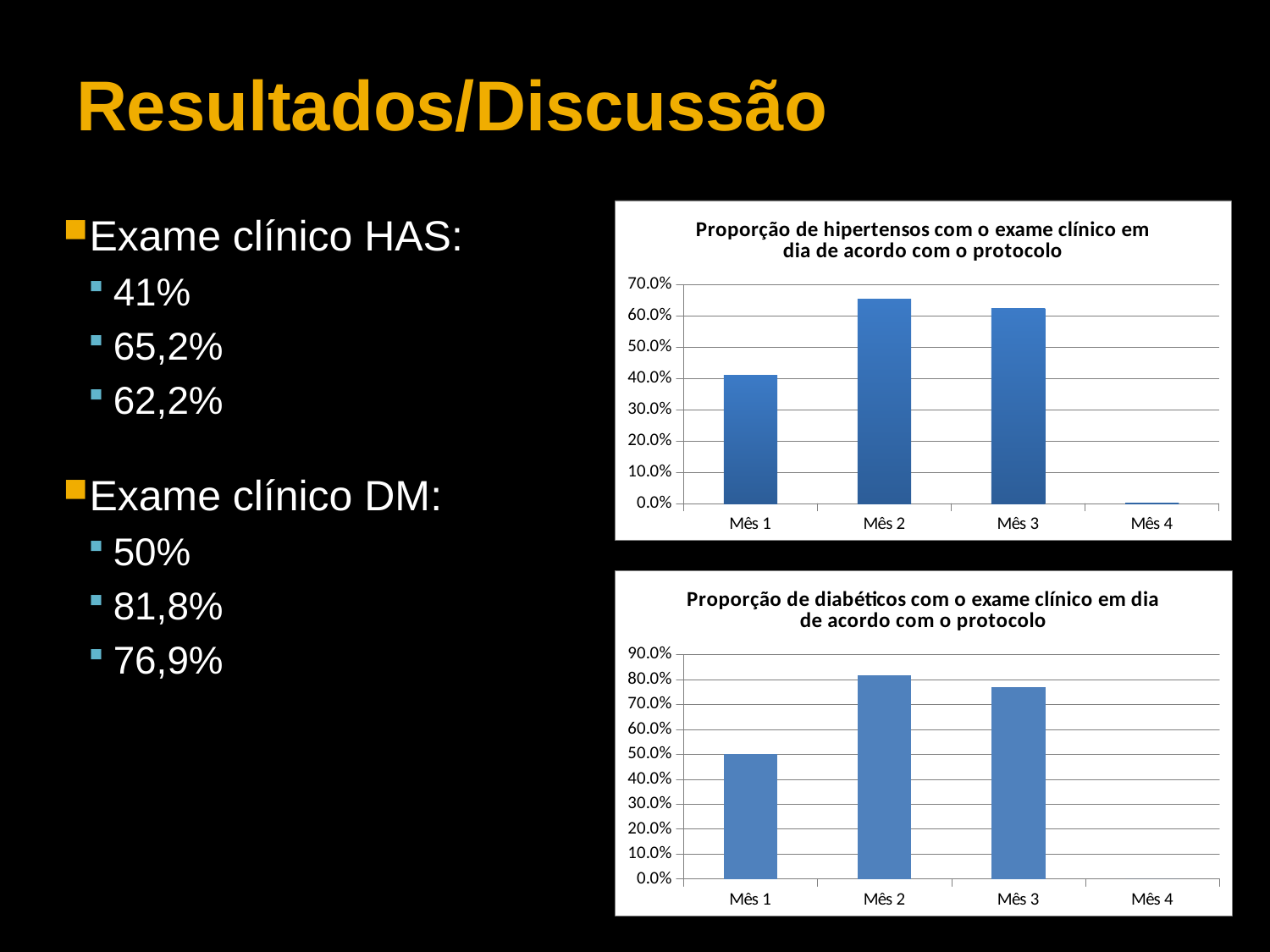
In the top chart (hipertensos), is the value for Mês 1 greater or less than 50.0%? less In the bottom chart (diabéticos), is the value for Mês 2 greater or less than 80.0%? greater What kind of chart is the top chart, 'Proporção de hipertensos com o exame clínico em dia de acordo com o protocolo'? bar chart What is the highest value shown on the y axis of the bottom chart (diabéticos)? 90.0% In the bottom chart (diabéticos), what is the value for Mês 1? 50.0% In the top chart (hipertensos), which is larger, the value for Mês 1 or the value for Mês 3? Mês 3 In the top chart (hipertensos), which month has the lowest bar? Mês 4 In the bottom chart (diabéticos), is the value for Mês 3 greater or less than 80.0%? less How many categories are shown on the x axis of the bottom chart, 'Proporção de diabéticos com o exame clínico em dia de acordo com o protocolo'? 4 In the top chart (hipertensos), which month has the highest bar? Mês 2 In the bottom chart (diabéticos), which month has the highest bar? Mês 2